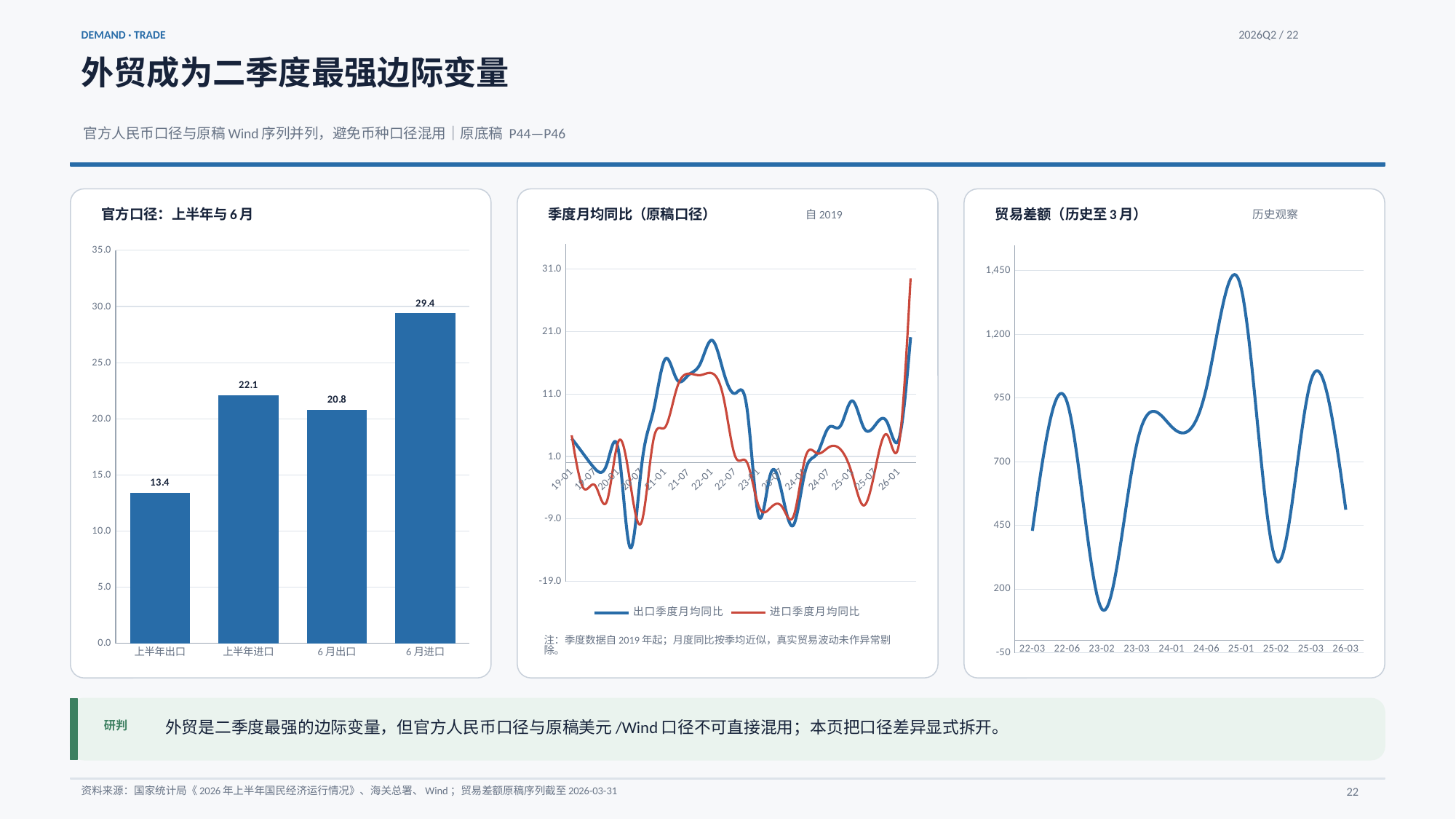
How many bars are shown in the chart titled 官方口径：上半年与6月? 4 In the chart titled 官方口径：上半年与6月, what is the difference between 6月进口 and 上半年进口? 7.3 What kind of chart is the one titled 贸易差额（历史至3月）? line chart In the chart titled 官方口径：上半年与6月, what is the value for 6月出口? 20.8 In the chart titled 官方口径：上半年与6月, which is larger, 6月出口 or 上半年进口? 上半年进口 In the chart titled 贸易差额（历史至3月）, is the value at 25-01 greater or less than 1,200? greater In the chart titled 官方口径：上半年与6月, which category has the lowest value? 上半年出口 In the chart titled 季度月均同比（原稿口径）, which series is drawn in red? 进口季度月均同比 How many series does the legend list in the chart titled 季度月均同比（原稿口径）? 2 What kind of chart is the one titled 官方口径：上半年与6月? bar chart In the chart titled 官方口径：上半年与6月, what is the value for 上半年进口? 22.1 In the chart titled 官方口径：上半年与6月, which category has the highest value? 6月进口